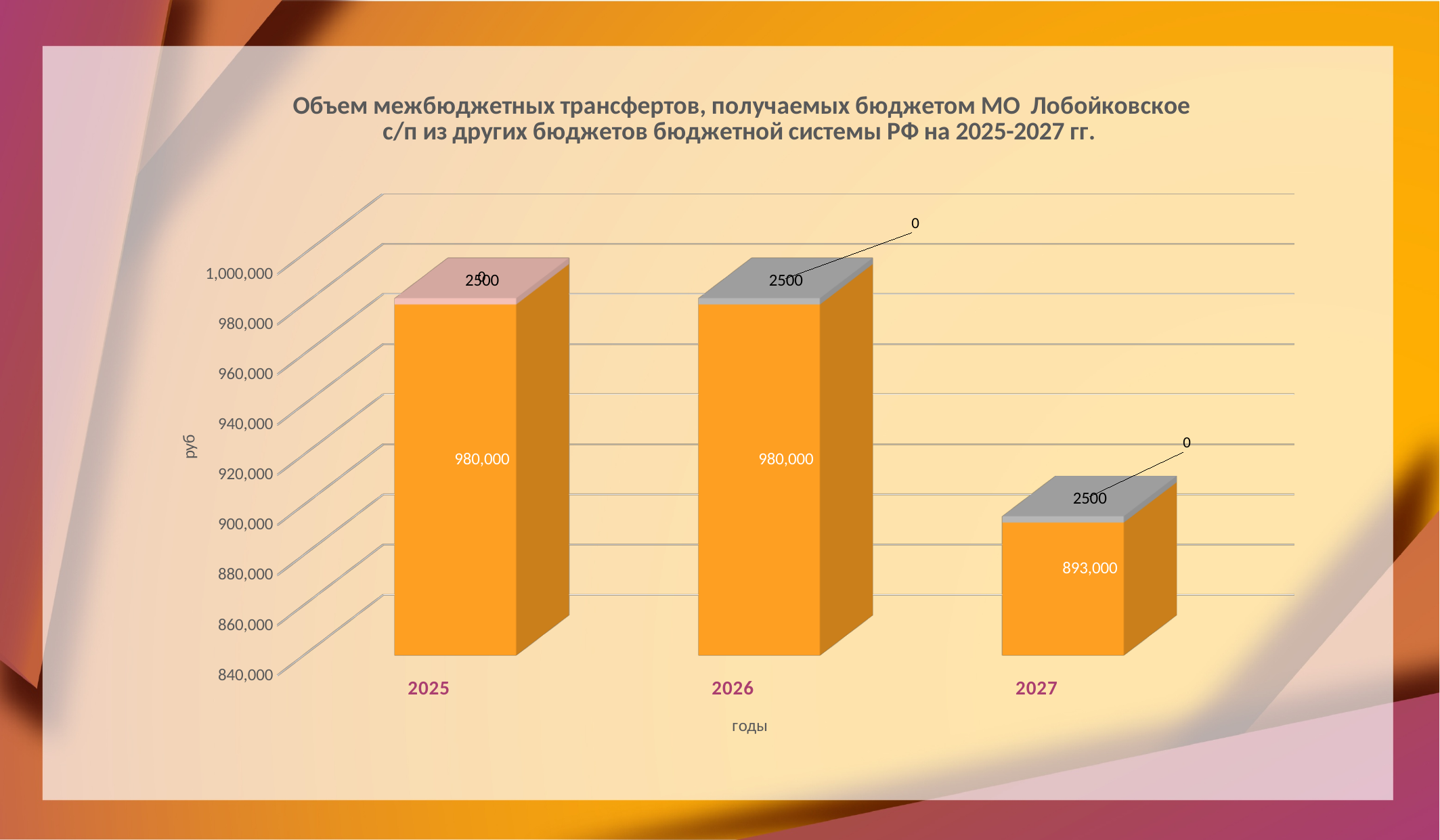
What is the value of the orange segment for 2026? 980,000 What is the value of the orange segment for 2025? 980,000 What is the value of the orange segment for 2027? 893,000 What is the difference between the orange segment values for 2026 and 2027? 87,000 What kind of chart is shown on the slide? bar chart Do the orange segment values rise or fall from 2025 to 2027? fall Which year has the lowest orange segment value? 2027 What value is labelled on the top (grey) segment of the 2027 bar? 2500 How many years are shown on the x axis? 3 What is the label of the vertical axis? руб Which is larger, the orange segment value for 2026 or for 2027? 2026 Is the orange segment value for 2027 greater or less than 900,000? less